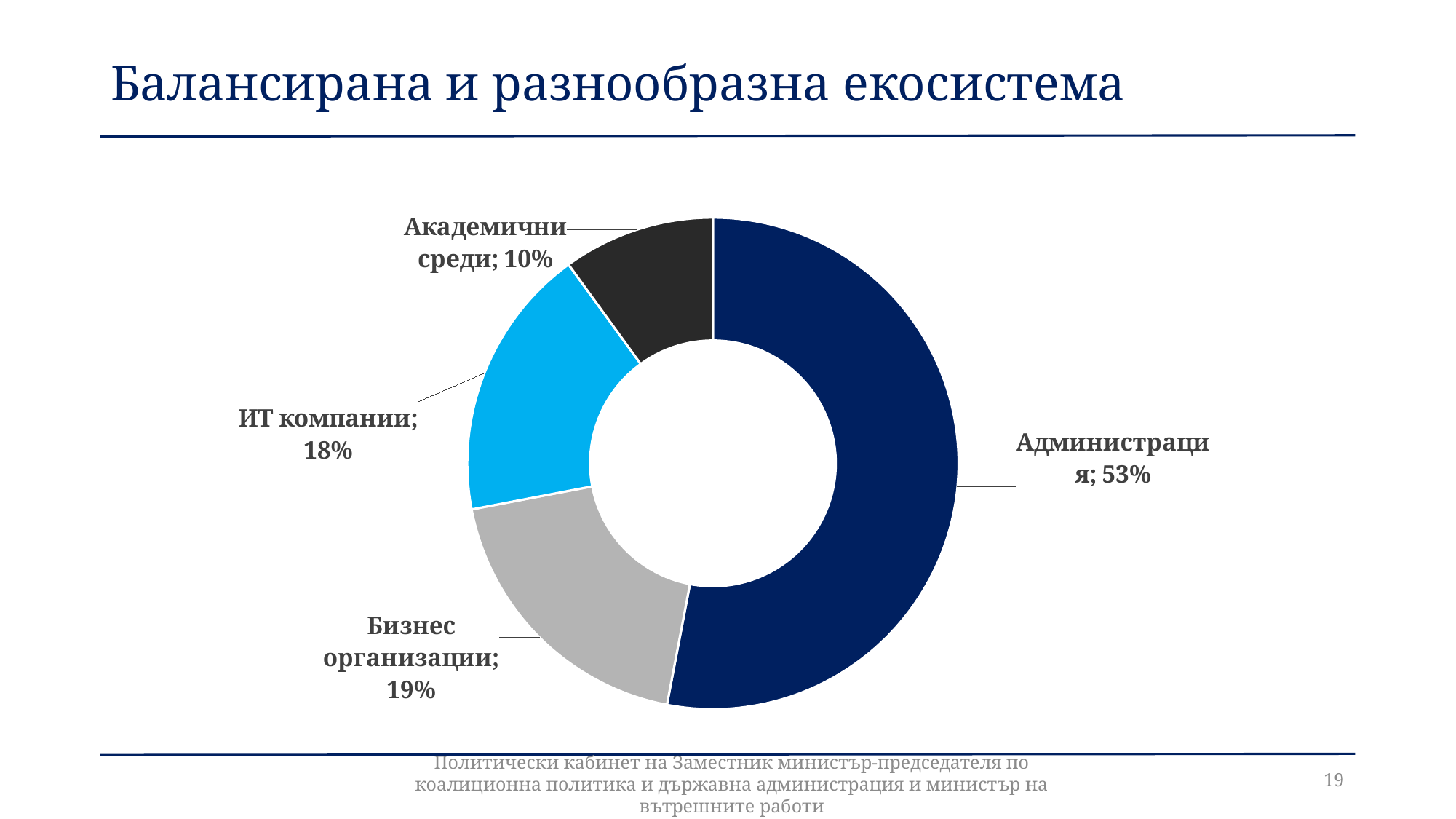
What percentage is shown for Бизнес организации? 19% What is the title of the slide containing the chart? Балансирана и разнообразна екосистема What is the difference in percentage points between Администрация and Бизнес организации? 34 What is the difference in percentage points between ИТ компании and Академични среди? 8 What share of the chart does Администрация account for? 53% How many categories are shown in the chart? 4 What kind of chart is shown on the slide? doughnut chart Which category has the largest share of the chart? Администрация Which has a larger share, Бизнес организации or ИТ компании? Бизнес организации What percentage is shown for Академични среди? 10% What percentage is shown for ИТ компании? 18% Which category has the smallest share of the chart? Академични среди